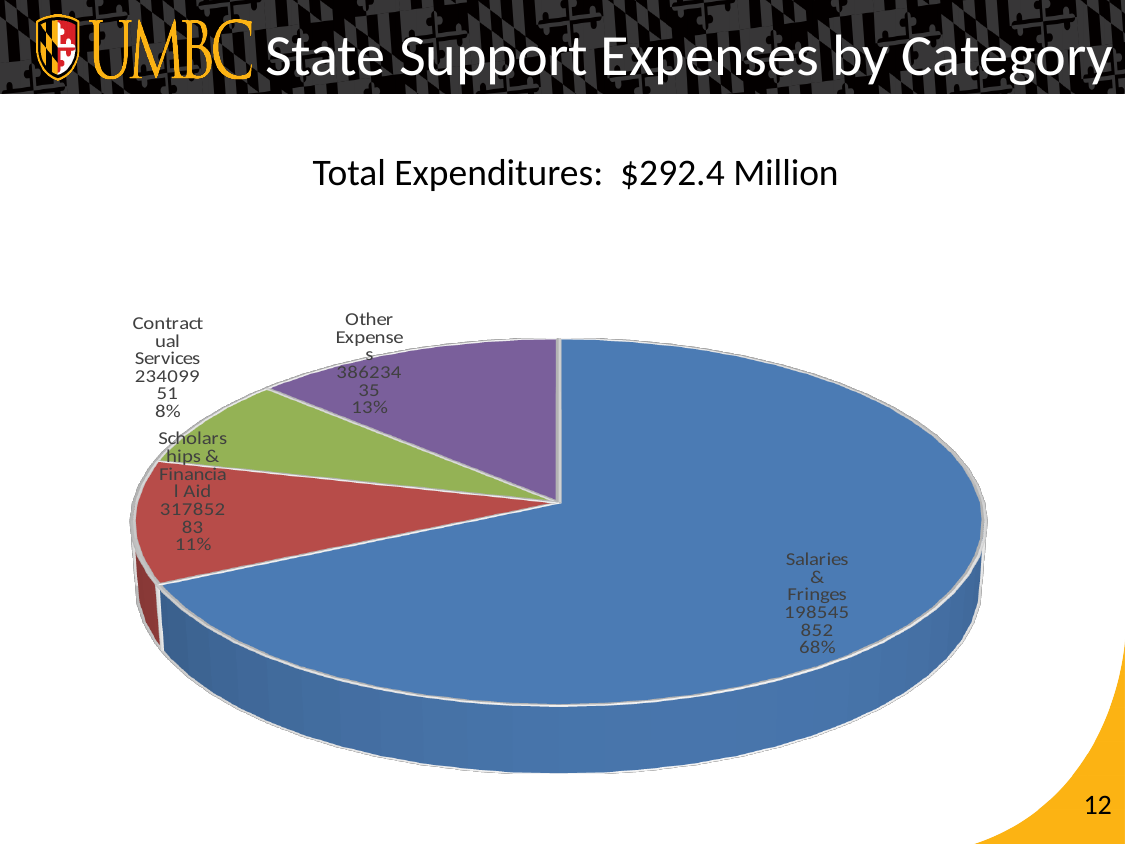
What percentage share of the pie does Salaries & Fringes have? 68% What percentage share of the pie does Other Expenses have? 13% Which category has the smallest slice of the pie? Contractual Services What type of chart is shown on the slide? pie chart What percentage share of the pie does Contractual Services have? 8% What total expenditure amount is stated above the chart? $292.4 Million Which category has the largest slice of the pie? Salaries & Fringes How many categories does the pie chart show? 4 Which is larger, the share for Other Expenses or the share for Scholarships & Financial Aid? Other Expenses What is the value shown for Salaries & Fringes? 198545852 What is the value shown for Other Expenses? 38623435